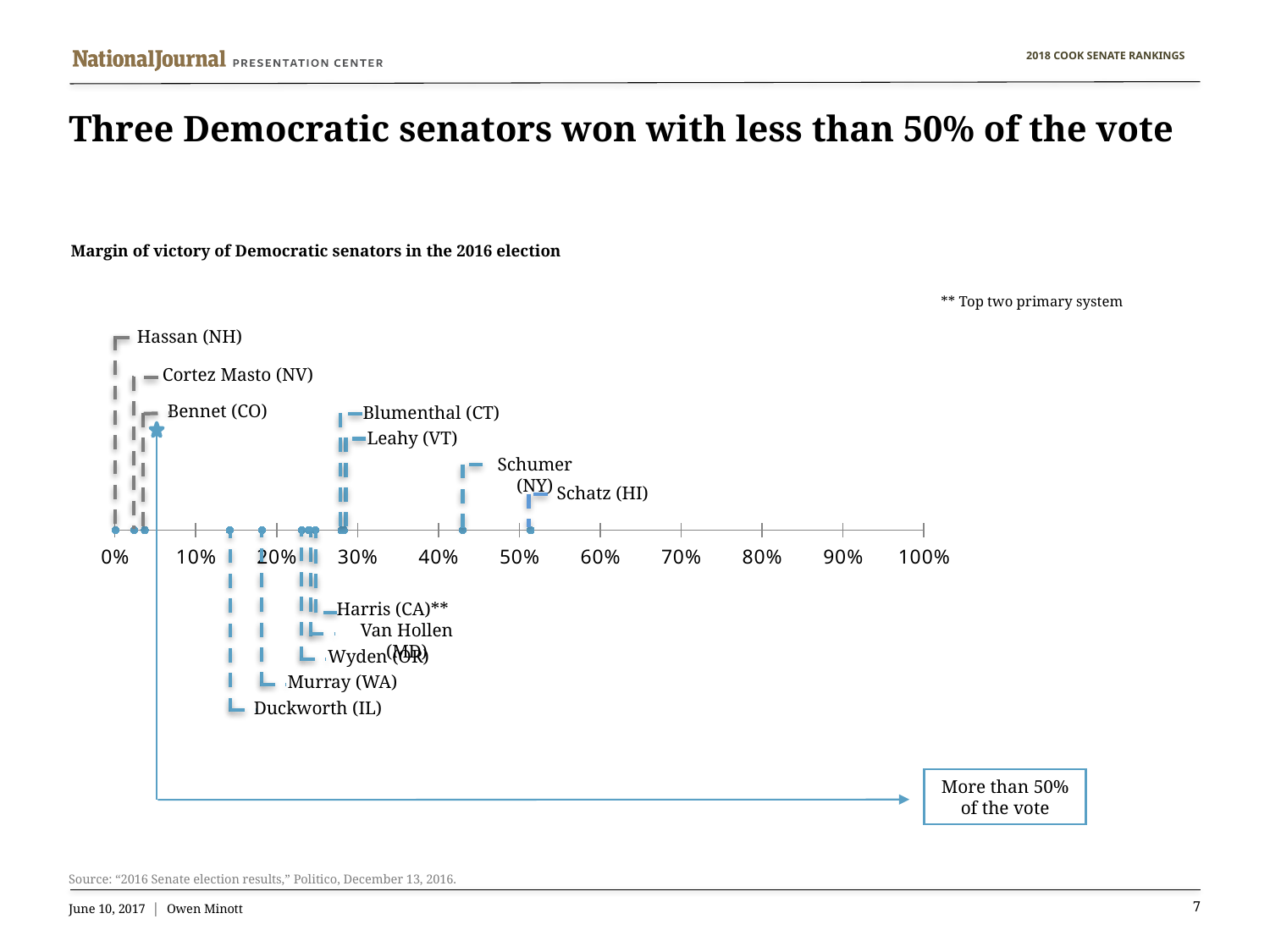
Which senator has the lowest margin of victory on the chart? Hassan (NH) Is the margin of victory for Harris (CA) greater or less than 30%? less Which senator had a larger margin of victory, Schumer (NY) or Duckworth (IL)? Schumer (NY) Which senator has the highest margin of victory on the chart? Schatz (HI) How many Democratic senators are plotted on the chart? 12 Is the margin of victory for Schumer (NY) greater or less than 50%? less What kind of chart is shown on the slide? Scatter (dot) chart Which senator's label carries the footnote marker for the top two primary system? Harris (CA) What is the title of the chart? Margin of victory of Democratic senators in the 2016 election Is the margin of victory for Duckworth (IL) greater or less than 10%? greater